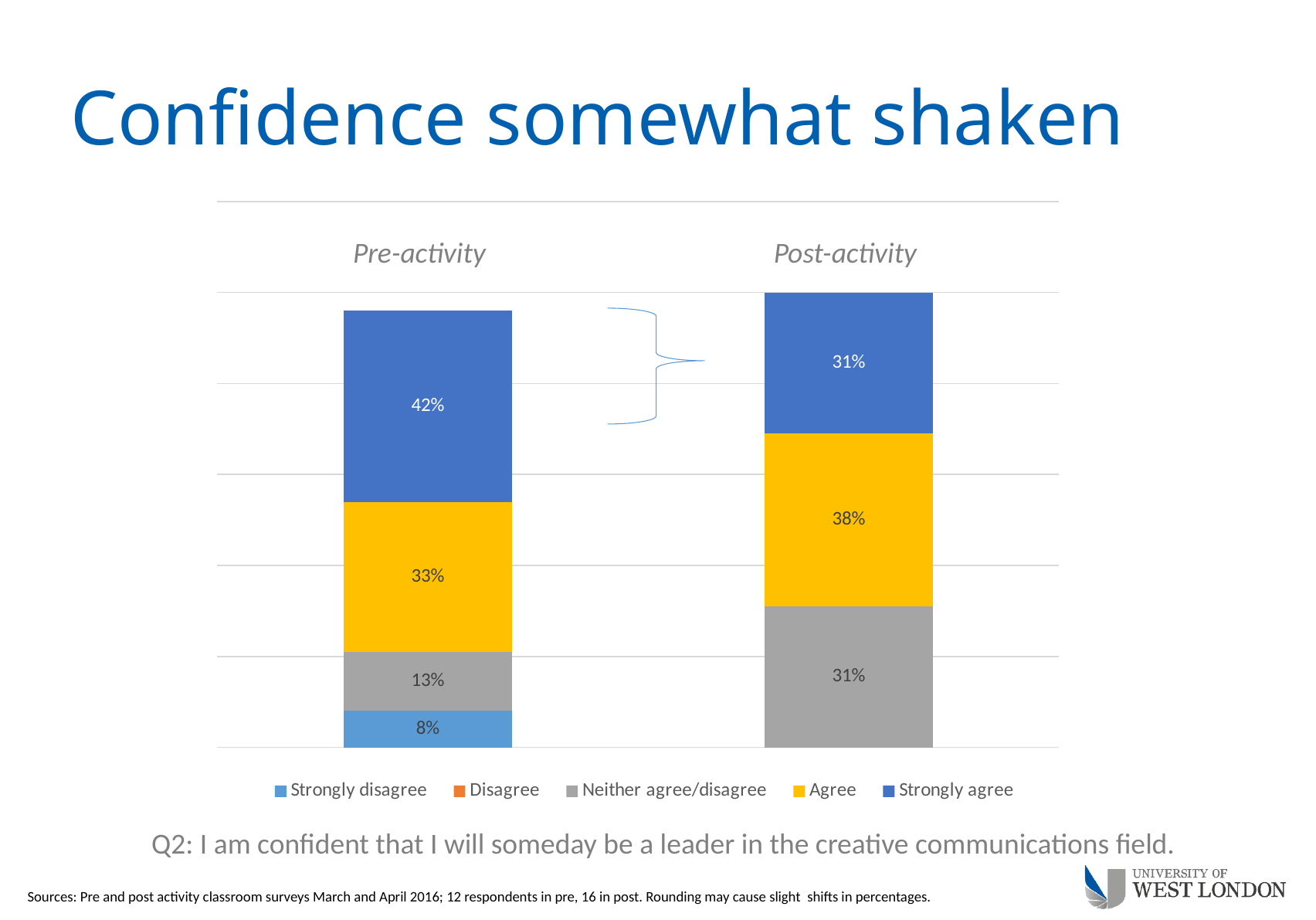
Which response segment is the largest in the Pre-activity bar? Strongly agree What is the Strongly disagree share in the Pre-activity bar? 8% How many bars are plotted in the chart? 2 How many series does the legend list? 5 By how many percentage points did the Strongly agree share fall from Pre-activity to Post-activity? 11 percentage points What is the Strongly agree share in the Post-activity bar? 31% What is the Neither agree/disagree share in the Pre-activity bar? 13% By how many percentage points did the Neither agree/disagree share rise from Pre-activity to Post-activity? 18 percentage points Which bar has the larger Agree share, Pre-activity or Post-activity? Post-activity What kind of chart is shown on the slide? Stacked bar chart What percentage of Post-activity respondents answered Agree? 38% What percentage of Pre-activity respondents answered Strongly agree? 42%